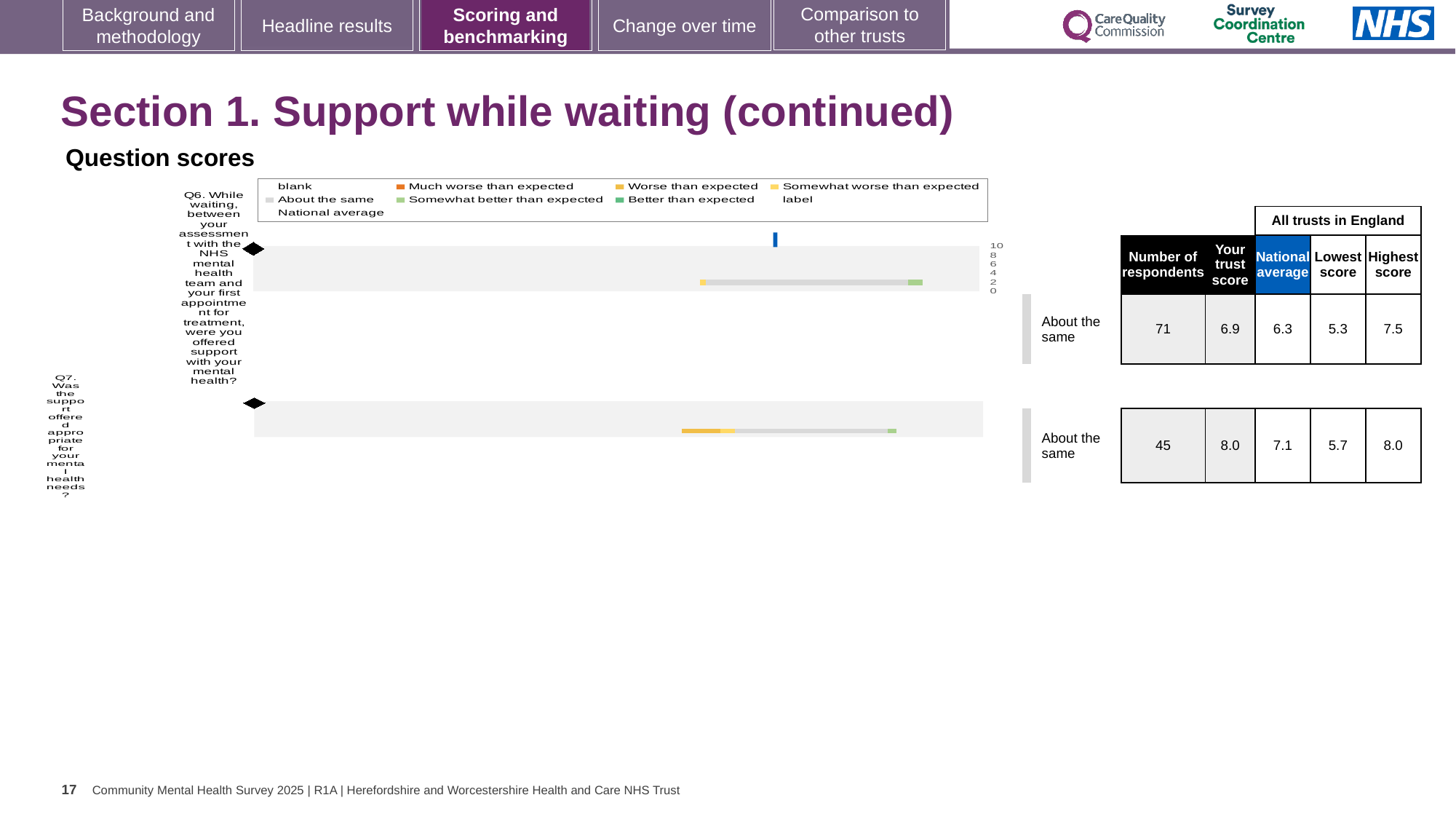
What is the difference between the trust score and the national average for Q7? 0.9 What kind of chart is shown under 'Question scores'? bar chart How many questions (categories) are plotted in the chart? 2 What benchmark category is shown for both Q6 and Q7? About the same What is the 'Your trust score' for Q6? 6.9 What is the difference between the highest score and the lowest score for Q6? 2.2 What is the highest value shown on the chart's axis? 10 Which question has the higher 'Your trust score', Q6 or Q7? Q7 Which question has more respondents, Q6 or Q7? Q6 What is the national average for Q7? 7.1 How many respondents answered Q6? 71 What is the lowest score across all trusts in England for Q7? 5.7